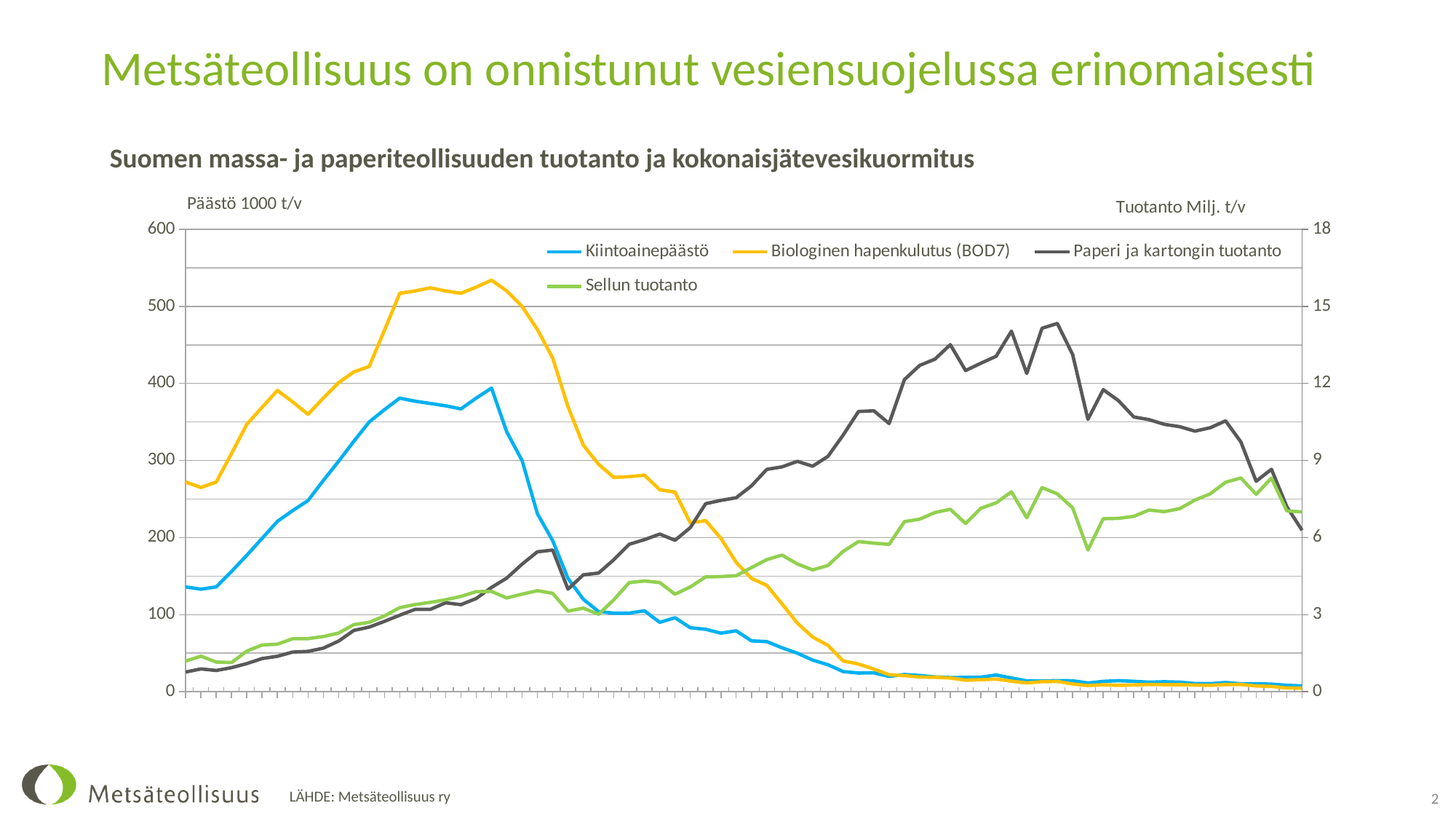
What kind of chart is shown on the slide? line chart Which series reaches the highest value on the left axis (Päästö 1000 t/v)? Biologinen hapenkulutus (BOD7) After reaching its peak, does the Kiintoainepäästö line rise or fall along the x axis? fall What is the title of the chart? Suomen massa- ja paperiteollisuuden tuotanto ja kokonaisjätevesikuormitus Is the peak value of Biologinen hapenkulutus (BOD7) greater or less than 500? greater Is the peak value of Sellun tuotanto on the right axis greater or less than 6? greater Is the peak value of Kiintoainepäästö greater or less than 300? greater Which series reaches the highest value on the right axis (Tuotanto Milj. t/v)? Paperi ja kartongin tuotanto Which series are listed in the chart legend? Kiintoainepäästö, Biologinen hapenkulutus (BOD7), Paperi ja kartongin tuotanto, Sellun tuotanto How many series does the chart legend list? 4 Over the whole chart, does the Sellun tuotanto line generally rise or fall from left to right? rise